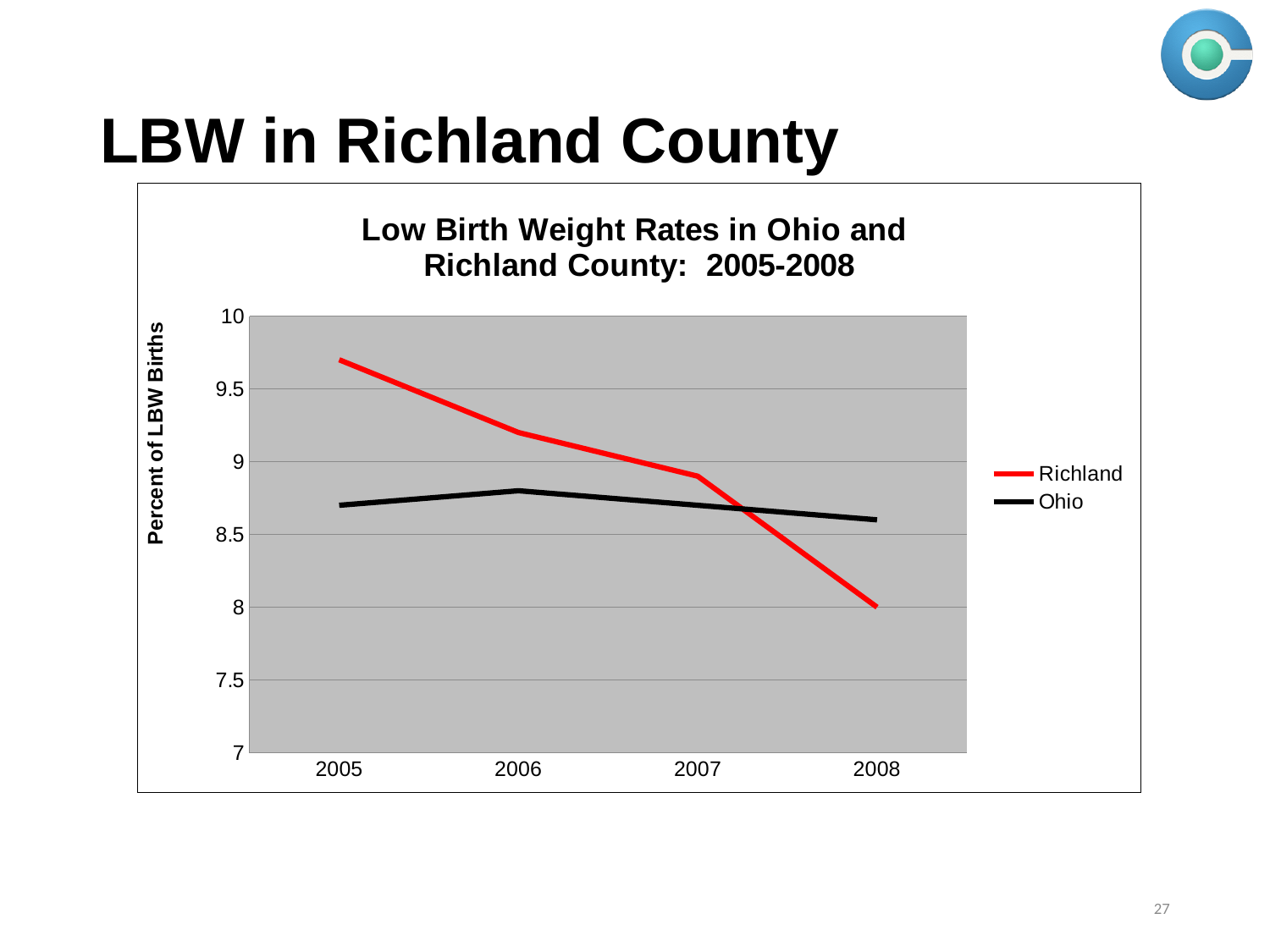
How many years are plotted along the x axis? 4 Is the value for Richland in 2008 greater or less than 8.5? less In 2008, which series has the higher value, Richland or Ohio? Ohio What kind of chart is shown on the slide? Line chart Is the value for Ohio in 2008 greater or less than 9? less In 2005, which series has the higher value, Richland or Ohio? Richland Is the value for Richland in 2005 greater or less than 9.5? greater In which year is the Richland value highest? 2005 How many series does the legend list? 2 What is the label on the y axis of the chart? Percent of LBW Births Does the Richland line rise or fall from 2005 to 2008? Fall In which year is the Richland value lowest? 2008